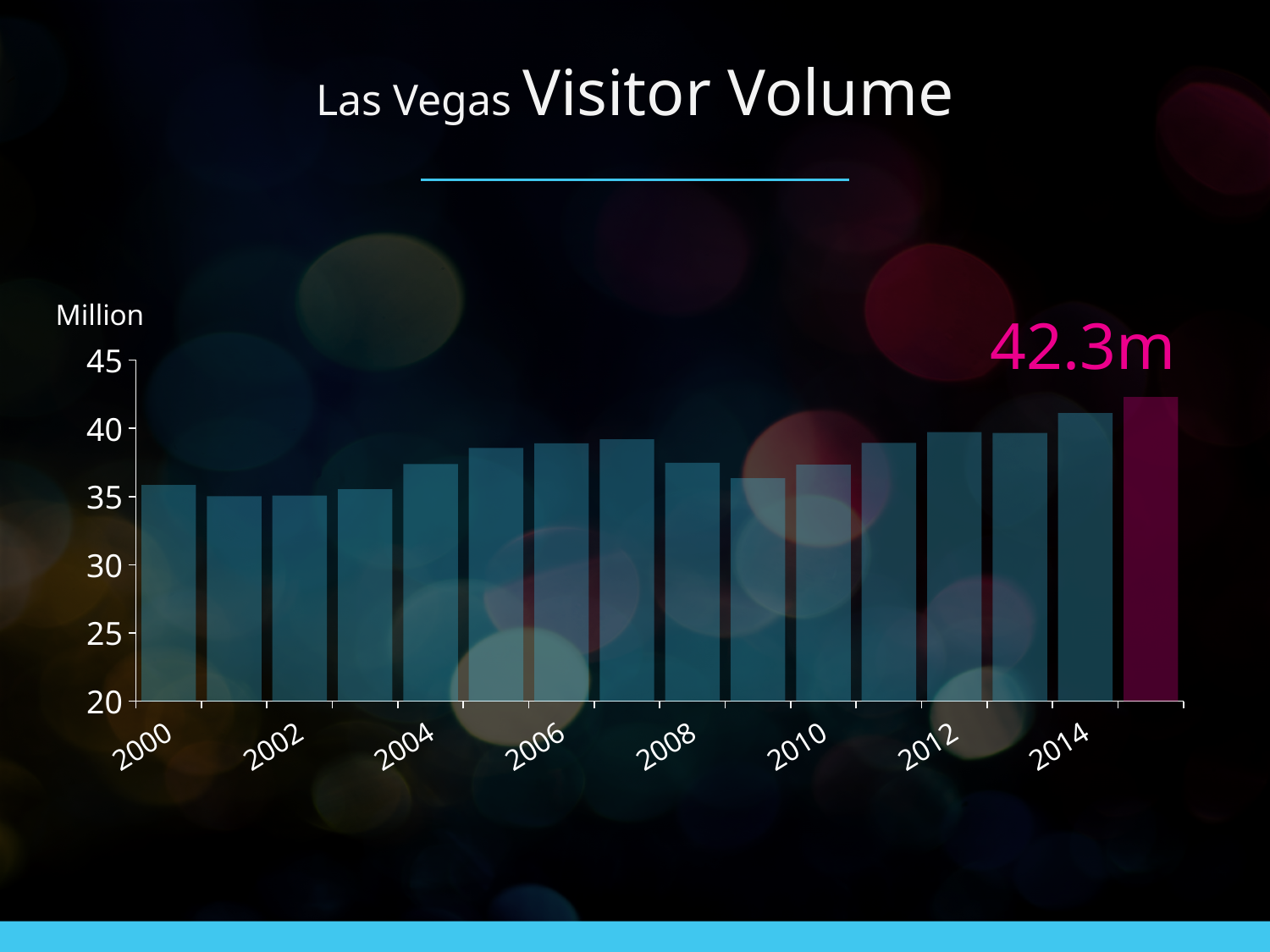
Is the value for 2014 greater or less than 40? greater What unit label is shown above the vertical axis? Million Overall, do visitor volumes rise or fall from 2000 to 2015? rise Which year has the highest visitor volume? 2015 What is the visitor volume shown for the highlighted final bar (2015)? 42.3m What is the title of the chart on the slide? Las Vegas Visitor Volume How many bars (years) are plotted in the chart? 16 What kind of chart is shown on the slide? bar chart Which year has the larger visitor volume, 2007 or 2009? 2007 Is the value for 2009 greater or less than 40? less Which year has the larger visitor volume, 2014 or 2009? 2014 Is the value for 2004 greater or less than 35? greater